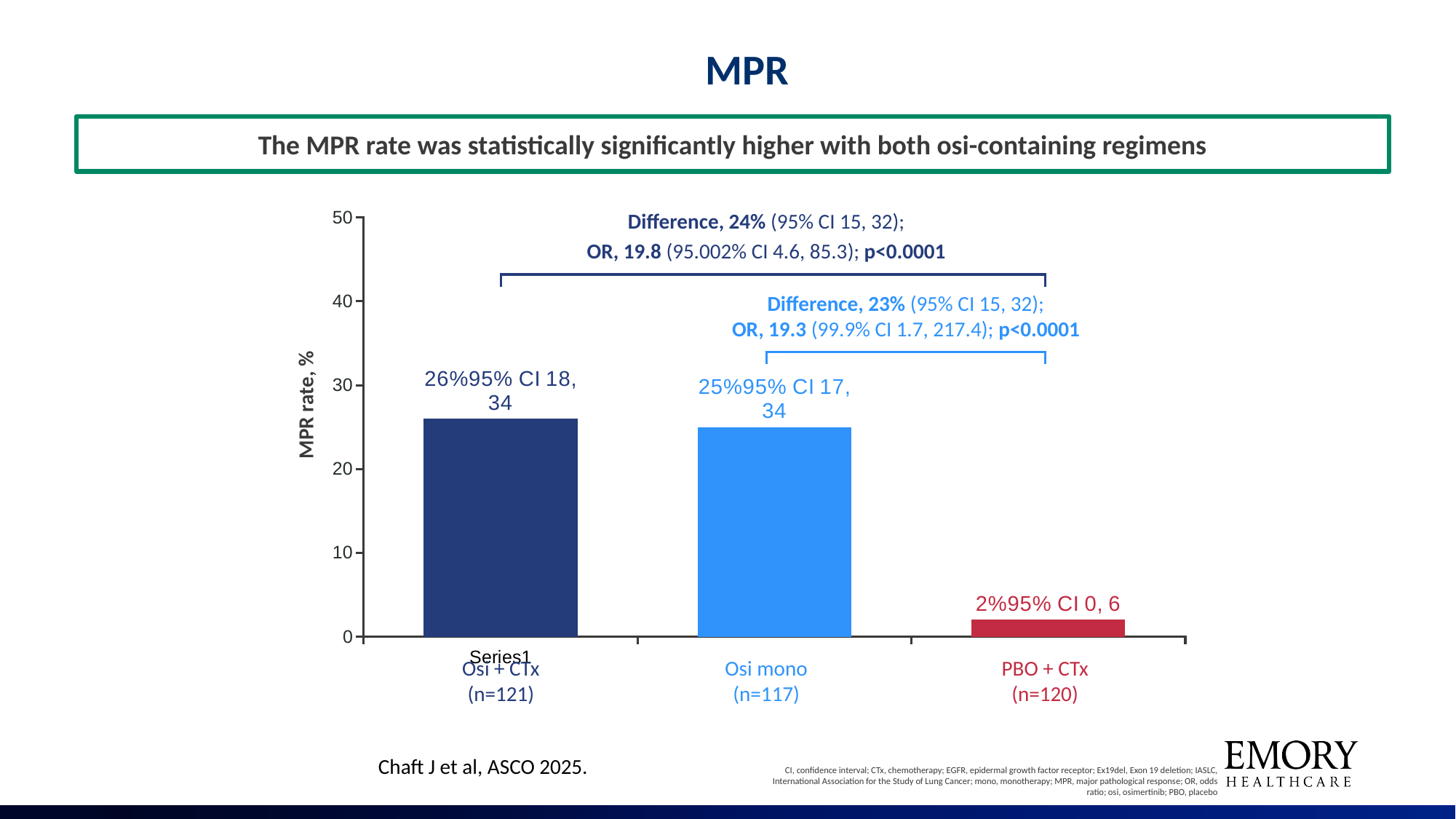
Which treatment arm has the highest MPR rate? Osi + CTx What is the MPR rate for PBO + CTx? 2% What is the MPR rate for Osi mono? 25% How many treatment arms are shown in the chart? 3 Which treatment arm has the lowest MPR rate? PBO + CTx What kind of chart is shown on the slide? Bar chart What is the difference in MPR rate between Osi mono and PBO + CTx? 23% What is the MPR rate for Osi + CTx? 26% Is the MPR rate for Osi + CTx greater or less than 20? greater Which has a higher MPR rate, Osi mono or PBO + CTx? Osi mono What is the difference in MPR rate between Osi + CTx and PBO + CTx? 24% What is the label of the y axis? MPR rate, %